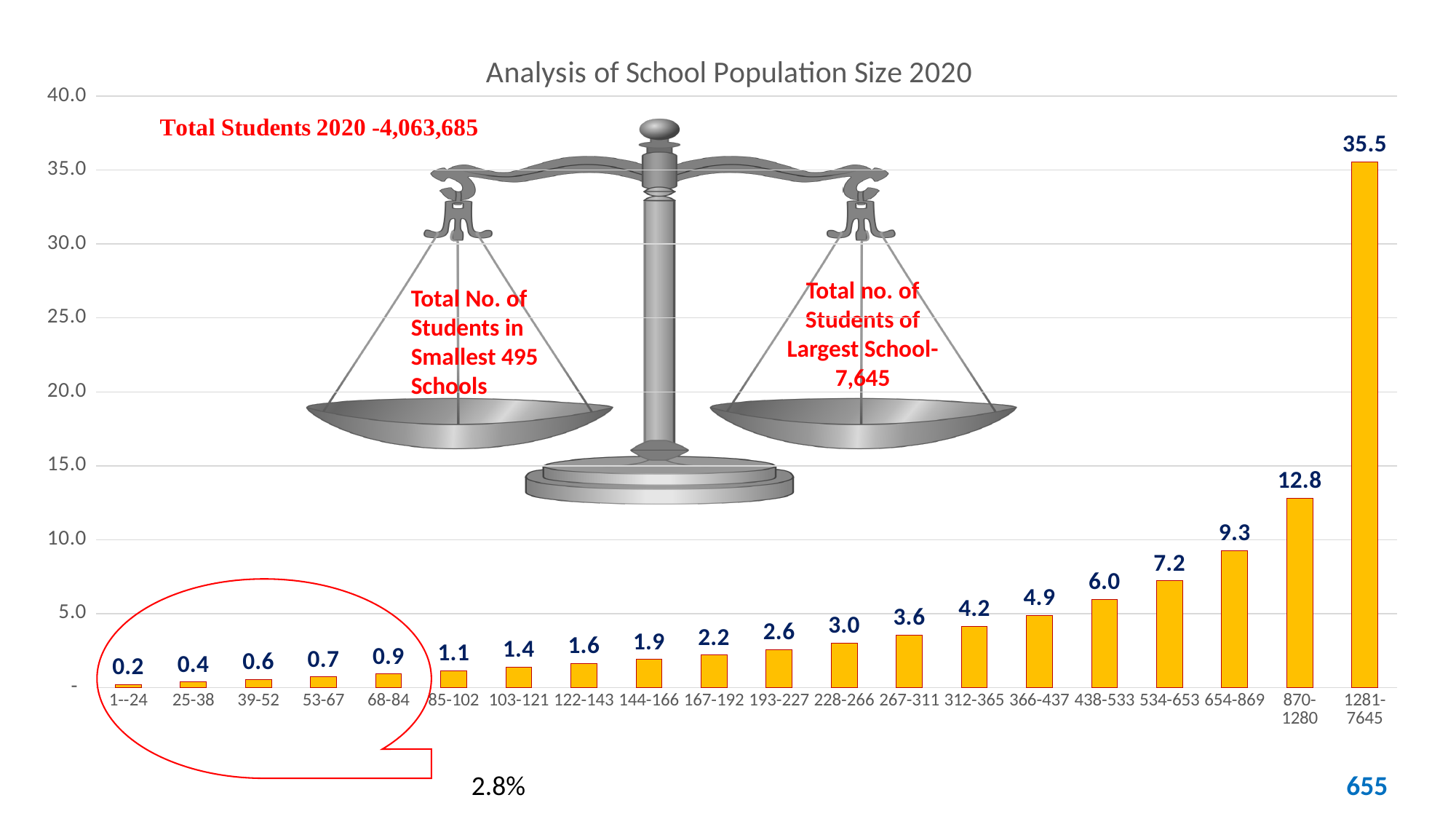
What is the value for the 228-266 category? 3.0 What is the title of the chart? Analysis of School Population Size 2020 Which is larger, the value for 654-869 or the value for 534-653? 654-869 Do the values rise or fall moving from left to right along the x axis? rise What is the difference between the values for 1281-7645 and 870-1280? 22.7 What is the value for the 1281-7645 category? 35.5 Which category has the highest value? 1281-7645 How many categories are shown on the x axis? 20 What type of chart is shown on the slide? bar chart What is the value for the 870-1280 category? 12.8 Which category has the lowest value? 1--24 What is the value for the 366-437 category? 4.9